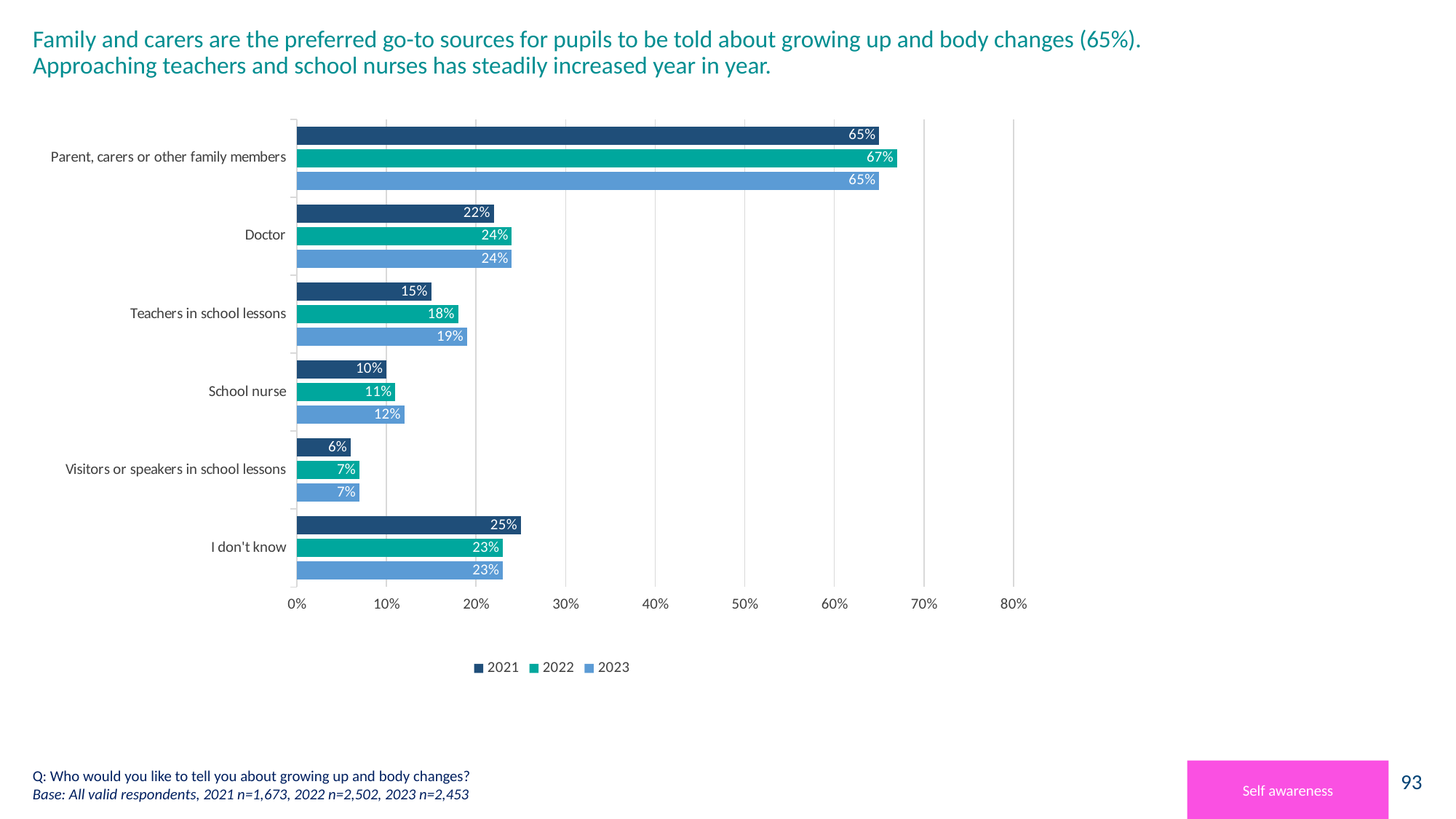
What is the value for 'School nurse' in 2023? 12% What percentage of pupils chose 'Parent, carers or other family members' in 2023? 65% What is the difference between the 2023 and 2021 values for 'Teachers in school lessons'? 4% What kind of chart is shown on the slide? Bar chart Which category has the highest value in 2022? Parent, carers or other family members How many categories are shown on the y axis of the chart? 6 Which year does the legend show in the lightest blue colour? 2023 How many series does the legend list? 3 Which category has the lowest value in 2021? Visitors or speakers in school lessons What is the value for 'Doctor' in 2021? 22% Which is larger: the 2021 value for 'I don't know' or the 2021 value for 'Doctor'? I don't know What is the value for 'Teachers in school lessons' in 2022? 18%